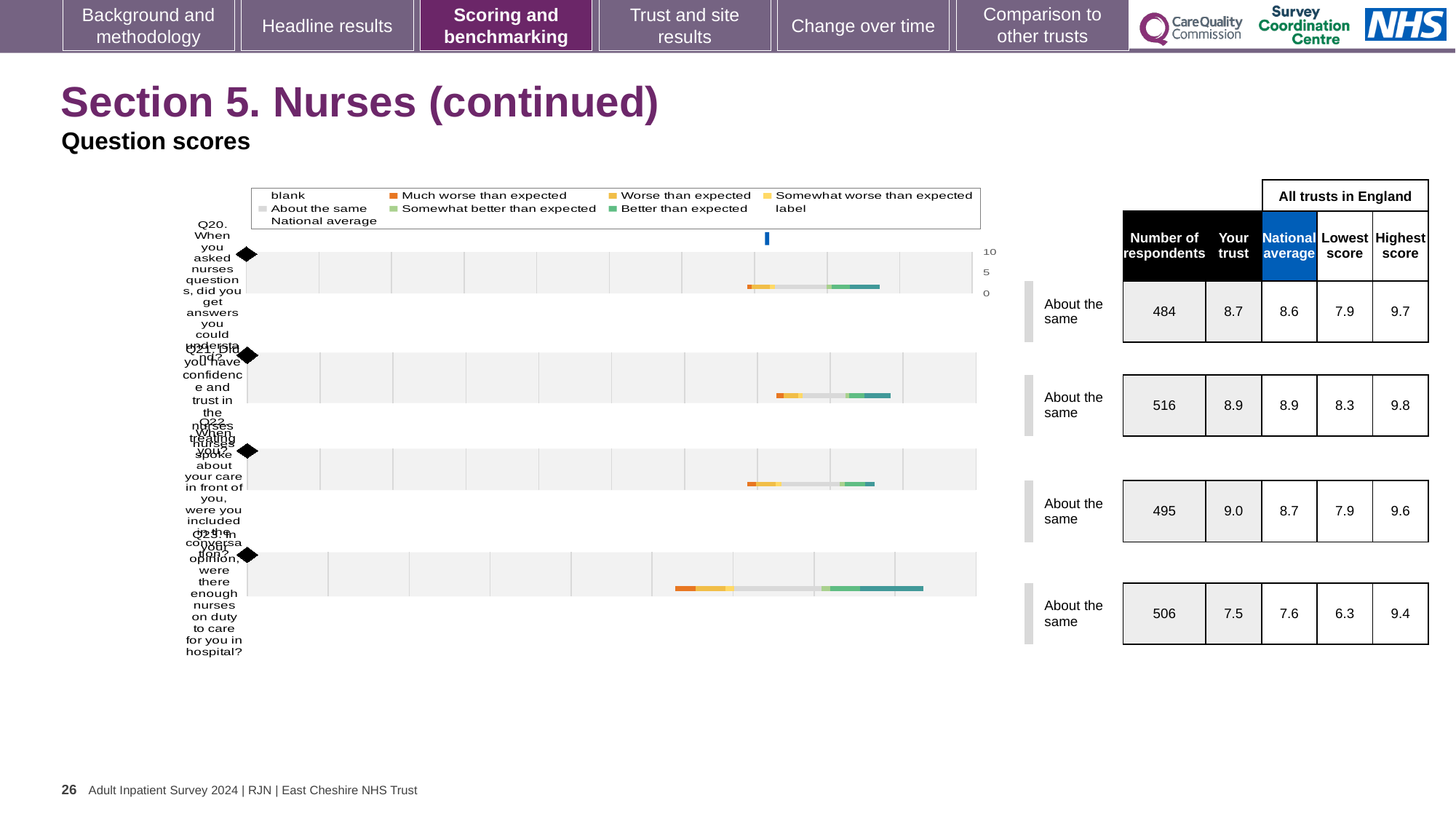
For Q23, what is the difference between the national average and the 'Your trust' score? 0.1 What kind of chart is used to show the question scores on this slide? bar chart What is the lowest score across all trusts in England for Q20? 7.9 What is the number of respondents for Q23 (were there enough nurses on duty to care for you in hospital)? 506 Which question has the highest 'Your trust' score? Q22 What is the 'Your trust' score for Q22 (when nurses spoke about your care in front of you, were you included in the conversation)? 9.0 For Q20, which is larger: the 'Your trust' score or the national average? Your trust What benchmark category is shown for all four questions on this slide? About the same What is the national average score for Q21 (did you have confidence and trust in the nurses treating you)? 8.9 Which question has the lowest 'Your trust' score? Q23 How many questions (rows) are plotted in the chart? 4 For Q21, what is the difference between the highest score and the lowest score across all trusts in England? 1.5